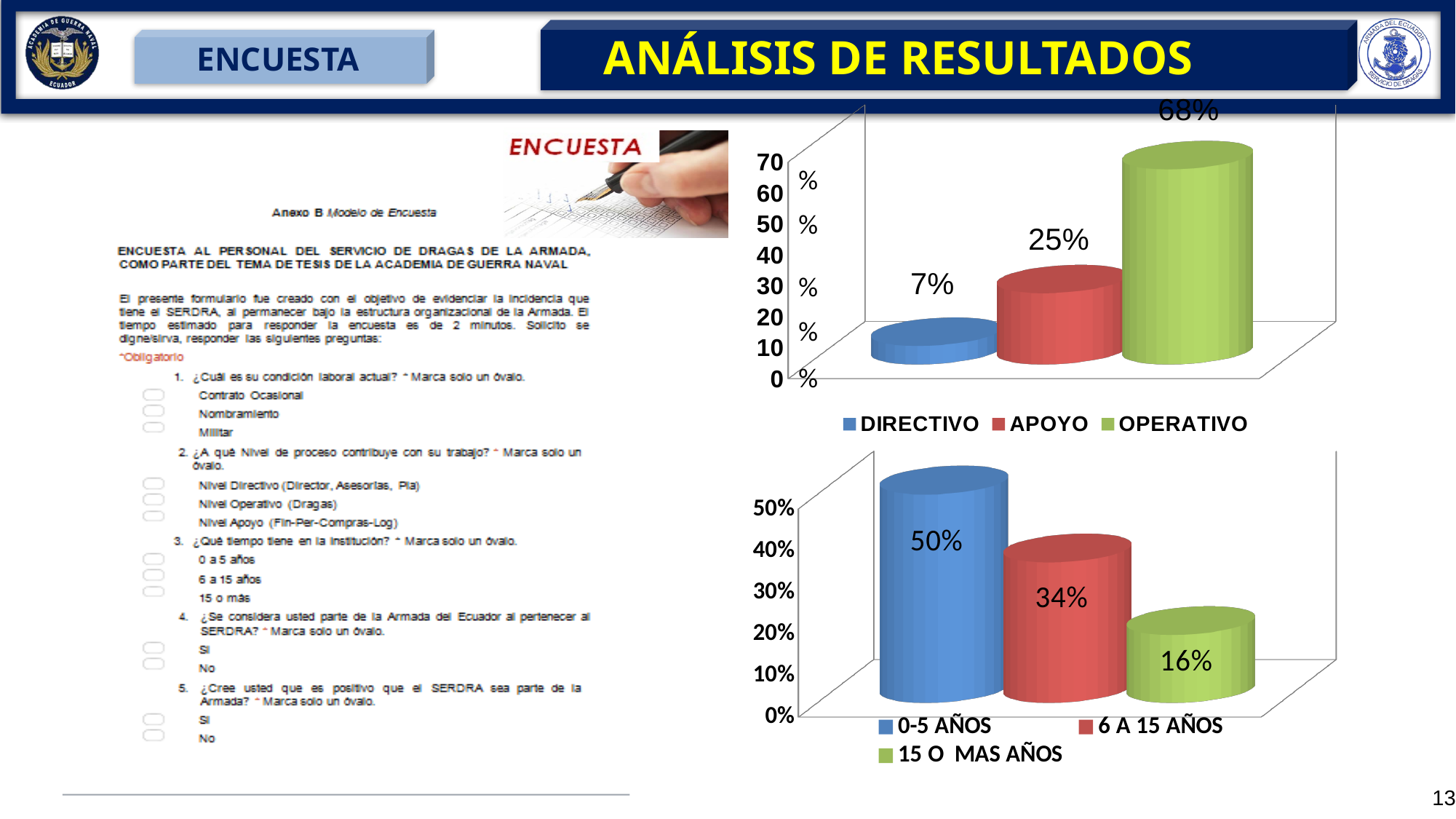
In the bottom chart, which category has the lowest value? 15 O MAS AÑOS In the bottom chart, do the values rise or fall from left to right? fall What kind of chart is the bottom chart? bar chart In the top chart, what colour is the bar for APOYO? red In the top chart, what is the value for OPERATIVO? 68% In the top chart, what is the value for DIRECTIVO? 7% In the bottom chart, what is the difference between the values for 0-5 AÑOS and 15 O MAS AÑOS? 34% In the top chart, how many entries does the legend list? 3 In the bottom chart, what is the value for 6 A 15 AÑOS? 34% In the top chart, which category has the highest value? OPERATIVO In the top chart, what is the difference between the values for OPERATIVO and APOYO? 43% In the bottom chart, which is larger, the value for 0-5 AÑOS or the value for 6 A 15 AÑOS? 0-5 AÑOS